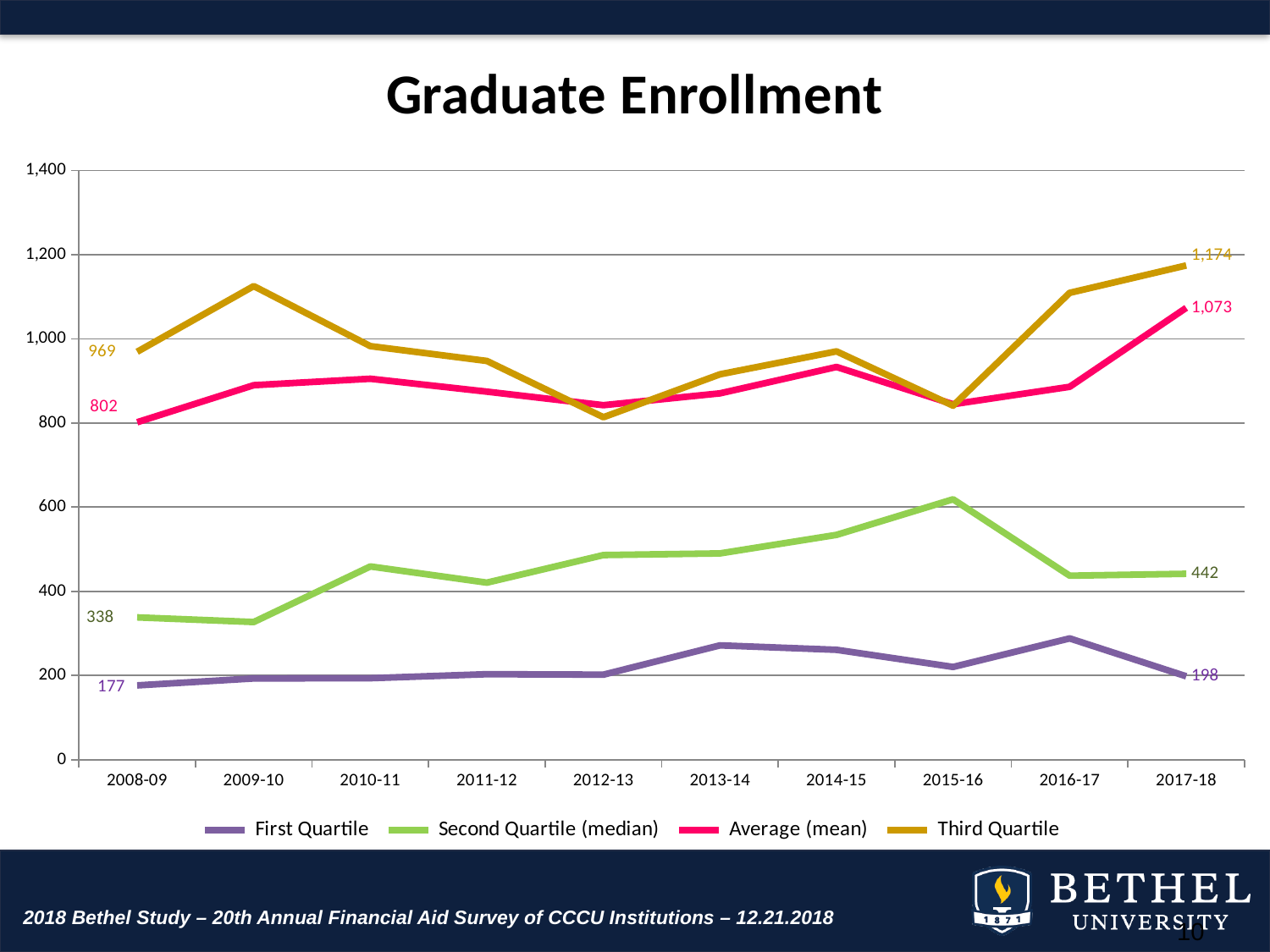
What is the Average (mean) value for 2008-09? 802 What is the Third Quartile value for 2017-18? 1,174 What type of chart is shown on the slide? line chart Which series has the lowest values across all years? First Quartile What is the First Quartile value for 2008-09? 177 How many series does the legend list? 4 Is the Second Quartile (median) value for 2015-16 greater or less than 600? greater What is the Second Quartile (median) value for 2017-18? 442 How many academic years are plotted along the x axis? 10 Which is larger in 2017-18, the Third Quartile or the Average (mean)? Third Quartile What is the title of the chart? Graduate Enrollment By how much did the Average (mean) change from 2008-09 to 2017-18? 271